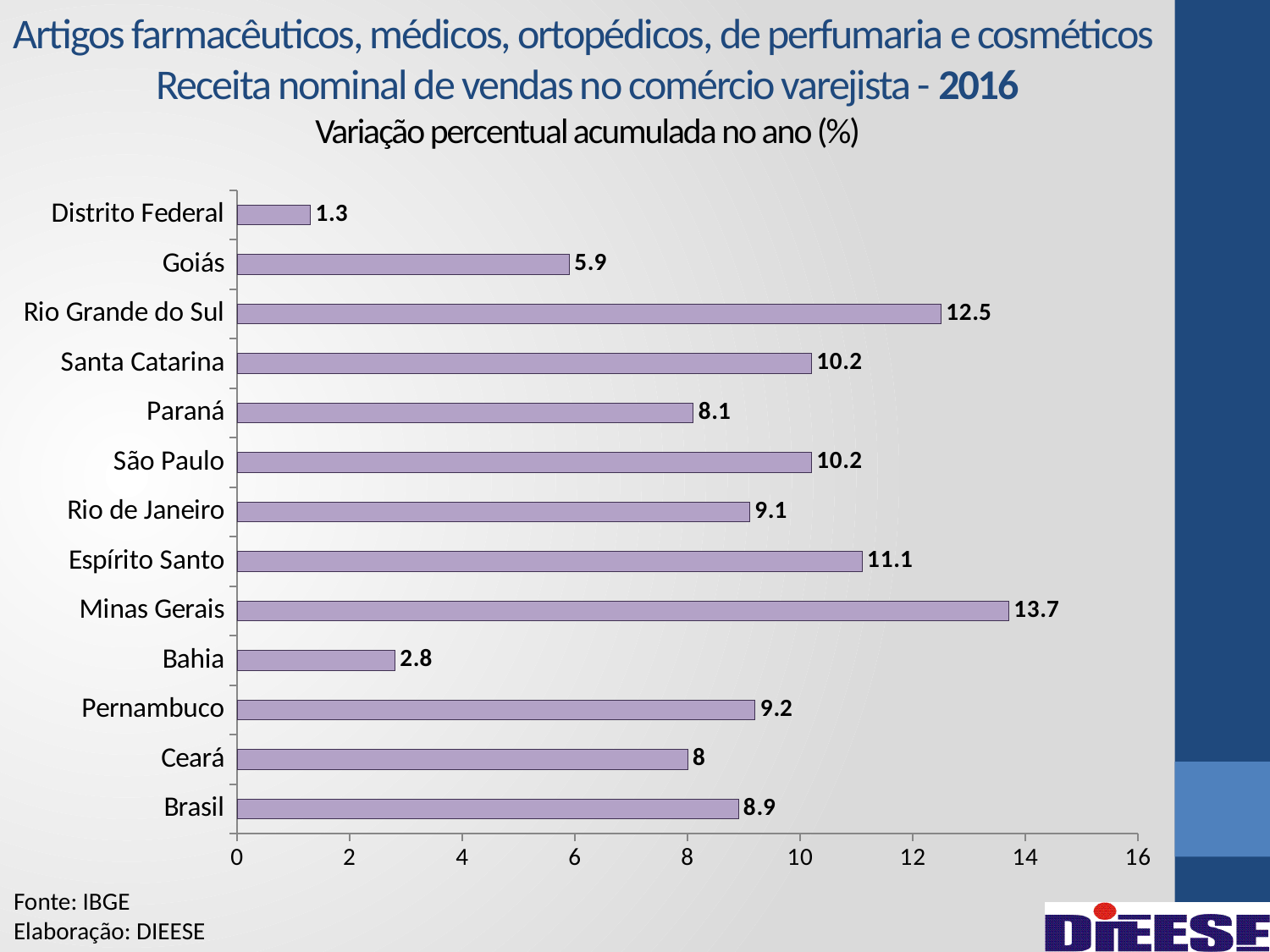
What is the value for Minas Gerais? 13.7 What is the value for Rio Grande do Sul? 12.5 Is the value for Espírito Santo greater or less than 10? greater What is the difference between the values for Minas Gerais and Bahia? 10.9 How many categories are shown on the chart? 13 Which is larger, the value for Pernambuco or the value for Rio de Janeiro? Pernambuco Which category has the lowest value? Distrito Federal What kind of chart is shown on the slide? bar chart What is the source cited for the chart data? IBGE Which category has the highest value? Minas Gerais What is the value for Brasil? 8.9 What is the difference between the values for Goiás and Distrito Federal? 4.6